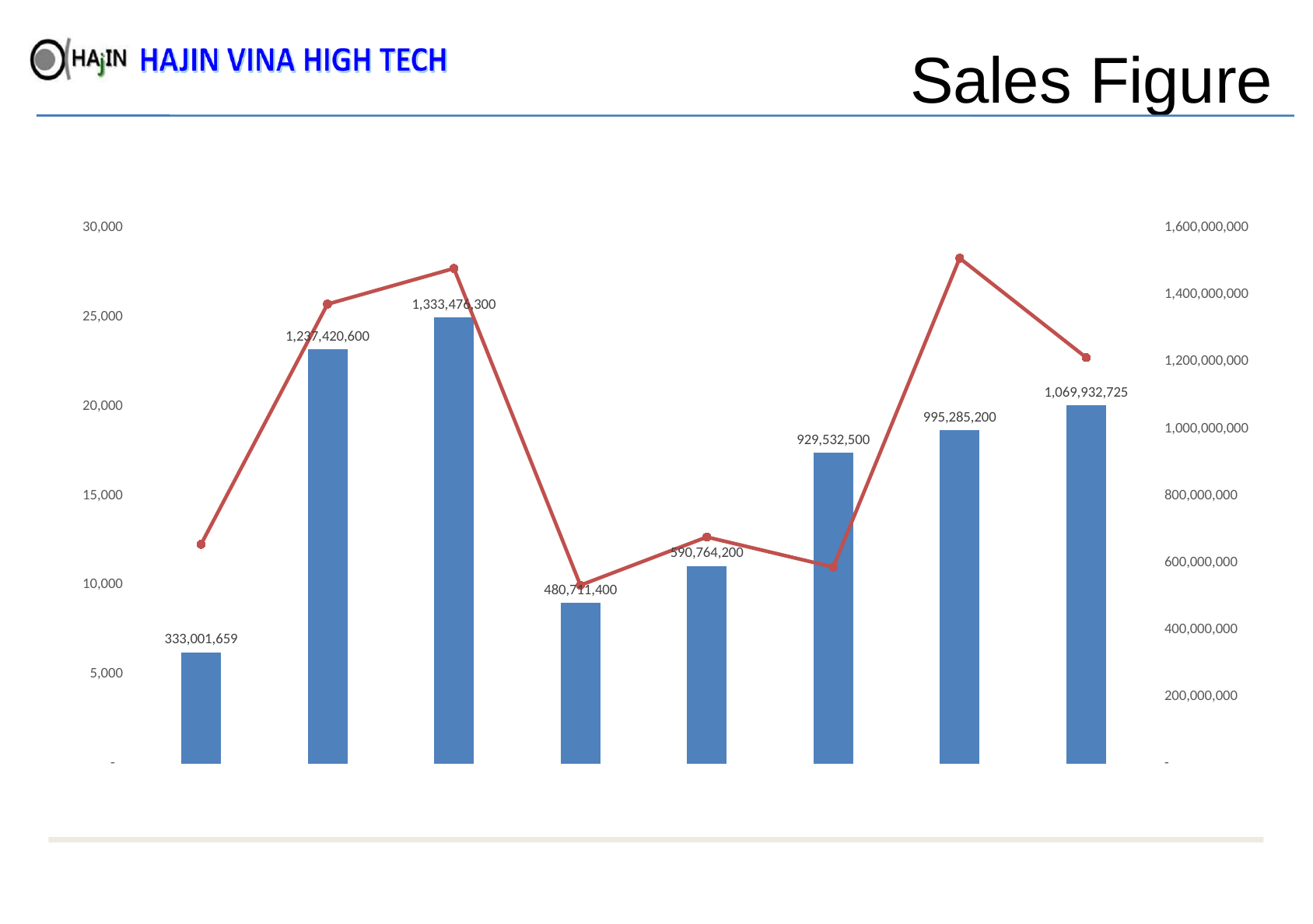
What is the difference between the eighth bar (1,069,932,725) and the seventh bar (995,285,200)? 74,647,525 What is the data label on the last (rightmost) bar? 1,069,932,725 How many bars are plotted in the chart? 8 Which is larger, the sixth bar or the seventh bar? The seventh bar (995,285,200) What kind of chart is shown on the slide? A combined bar and line chart What is the difference between the third bar (1,333,476,300) and the second bar (1,237,420,600)? 96,055,700 What is the data label on the first (leftmost) bar? 333,001,659 What is the data label on the third bar from the left? 1,333,476,300 Which bar has the lowest value? The first bar (333,001,659) On the left axis, is the value of the first point on the red line greater or less than 15,000? less On the left axis, is the value of the seventh point on the red line greater or less than 25,000? greater Which bar has the highest value? The third bar (1,333,476,300)